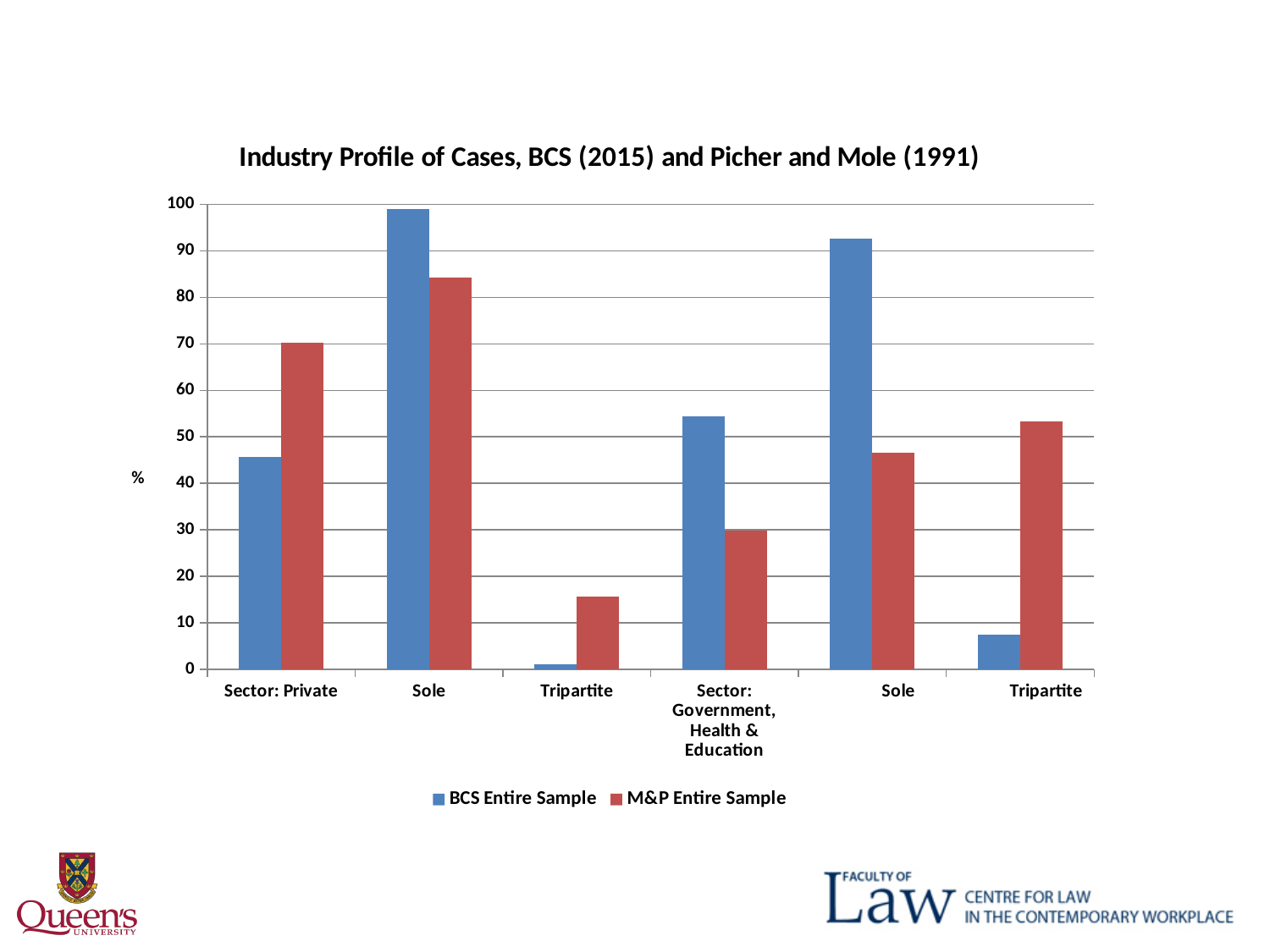
How many categories are shown along the x axis? 6 Is the BCS Entire Sample value for Sector: Private greater or less than 50? less Which category has the highest BCS Entire Sample value? Sole (the first one, after Sector: Private) What is the title of the chart? Industry Profile of Cases, BCS (2015) and Picher and Mole (1991) Is the M&P Entire Sample value for Sector: Private greater or less than 60? greater For Sector: Government, Health & Education, which series has the larger value, BCS Entire Sample or M&P Entire Sample? BCS Entire Sample Which category has the highest M&P Entire Sample value? Sole (the first one, after Sector: Private) What label is shown on the vertical axis? % Which category has the lowest M&P Entire Sample value? Tripartite (the first one, before Sector: Government, Health & Education) What kind of chart is shown on the slide? Bar chart Which category has the lowest BCS Entire Sample value? Tripartite (the first one, before Sector: Government, Health & Education) How many series does the legend list? 2